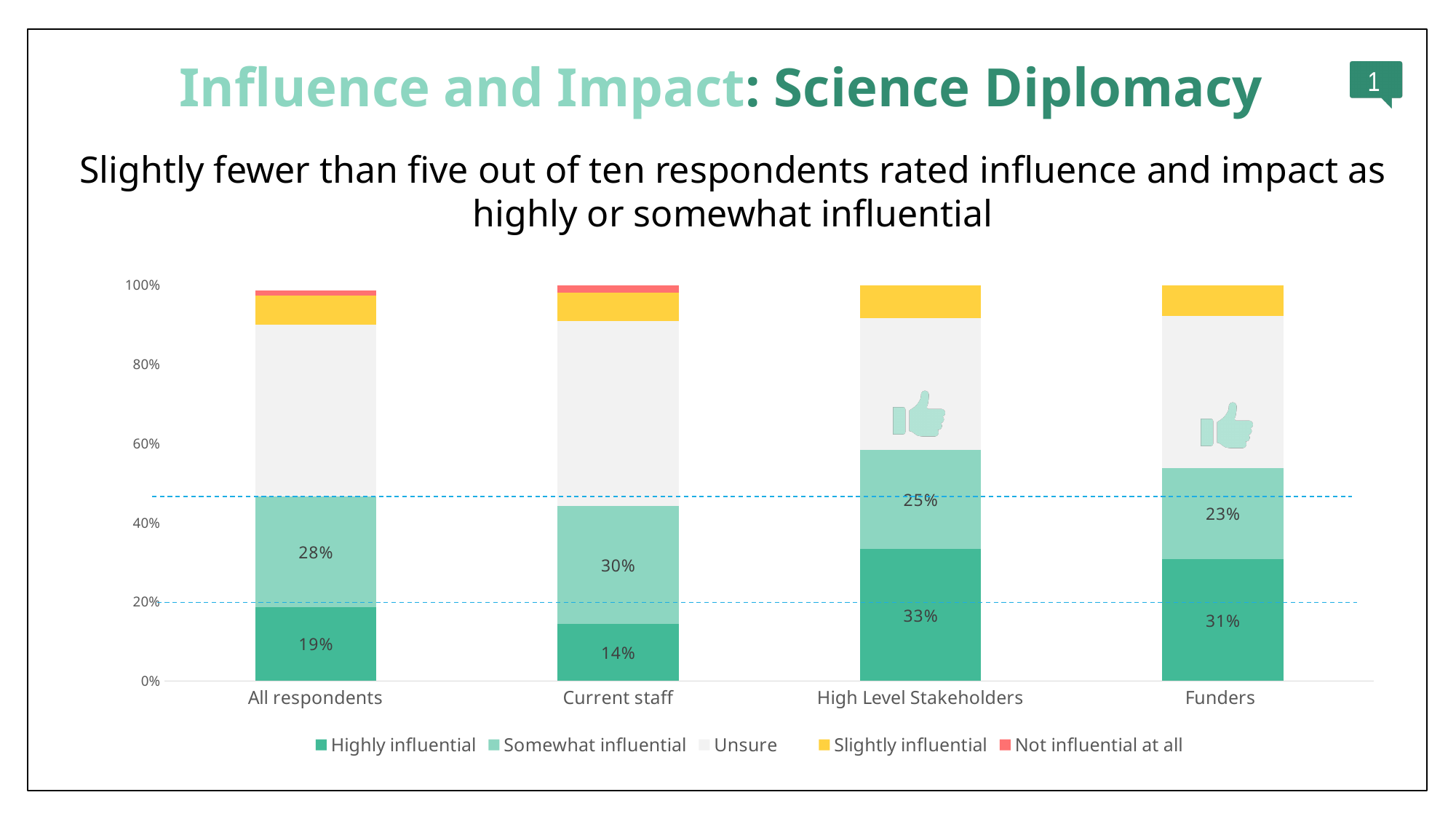
Which group has the highest Highly influential percentage? High Level Stakeholders What kind of chart is shown on the slide? Stacked bar chart What is the difference between the Highly influential values for High Level Stakeholders and Current staff? 19% What is the Highly influential value for High Level Stakeholders? 33% How many series does the legend list? 5 Which group has the highest Somewhat influential percentage? Current staff What is the Somewhat influential value for Funders? 23% Which is larger: the Somewhat influential value for All respondents or for Funders? All respondents Is the Unsure segment for Current staff greater or less than 40%? greater How many groups are shown on the x axis? 4 Which group has the lowest Highly influential percentage? Current staff What percentage of Current staff rated influence and impact as Highly influential? 14%